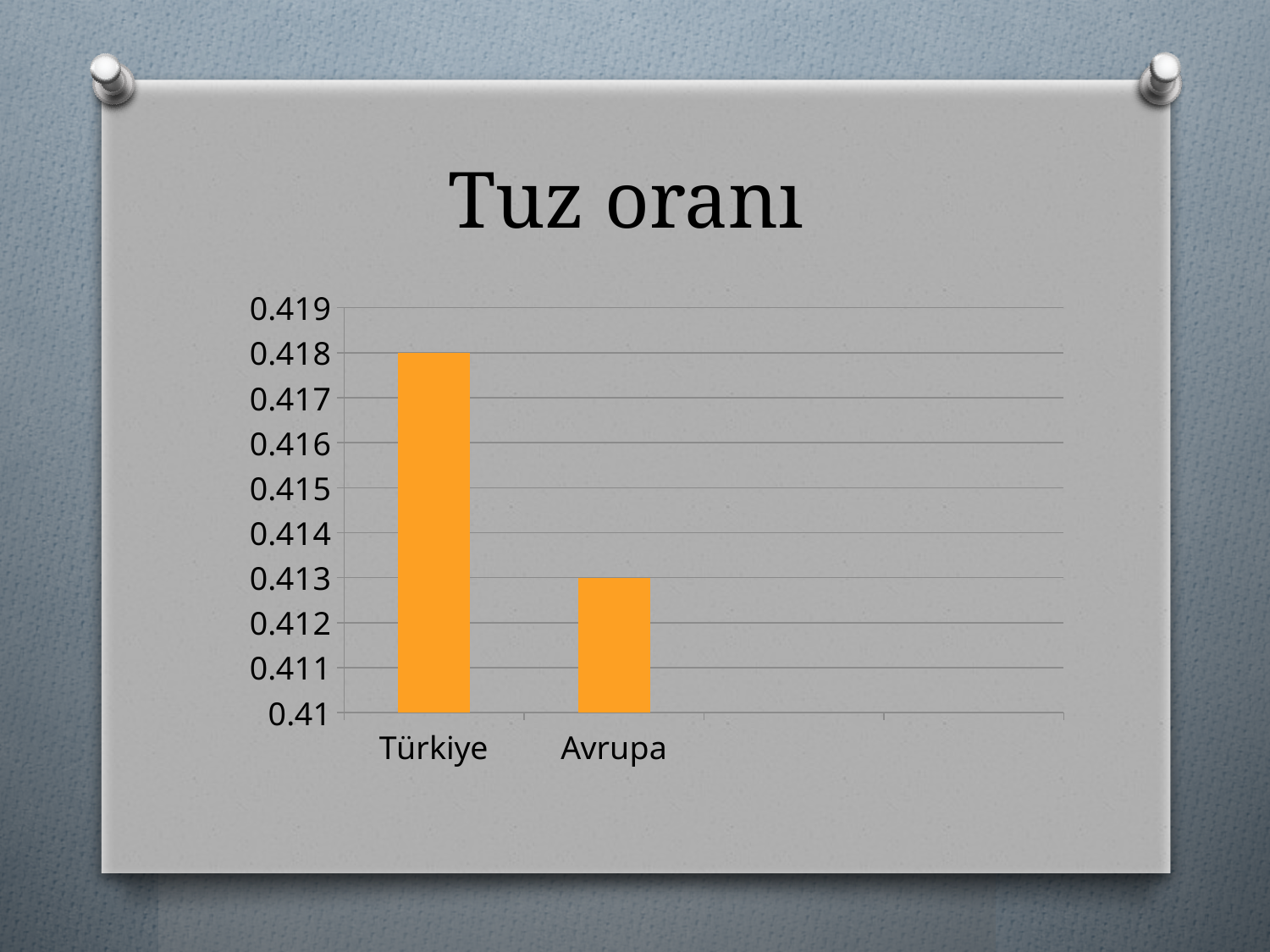
What kind of chart is shown on the slide? bar chart Which category has the lowest value? Avrupa Which category has the highest value? Türkiye What is the title of the chart? Tuz oranı What is the value for Türkiye? 0.418 Is the value for Avrupa greater or less than 0.415? less What is the value for Avrupa? 0.413 What colour are the bars in the chart? orange How many categories are shown on the x axis? 2 Is the value for Türkiye greater or less than 0.416? greater Which is larger, the value for Türkiye or the value for Avrupa? Türkiye What is the difference between the values for Türkiye and Avrupa? 0.005